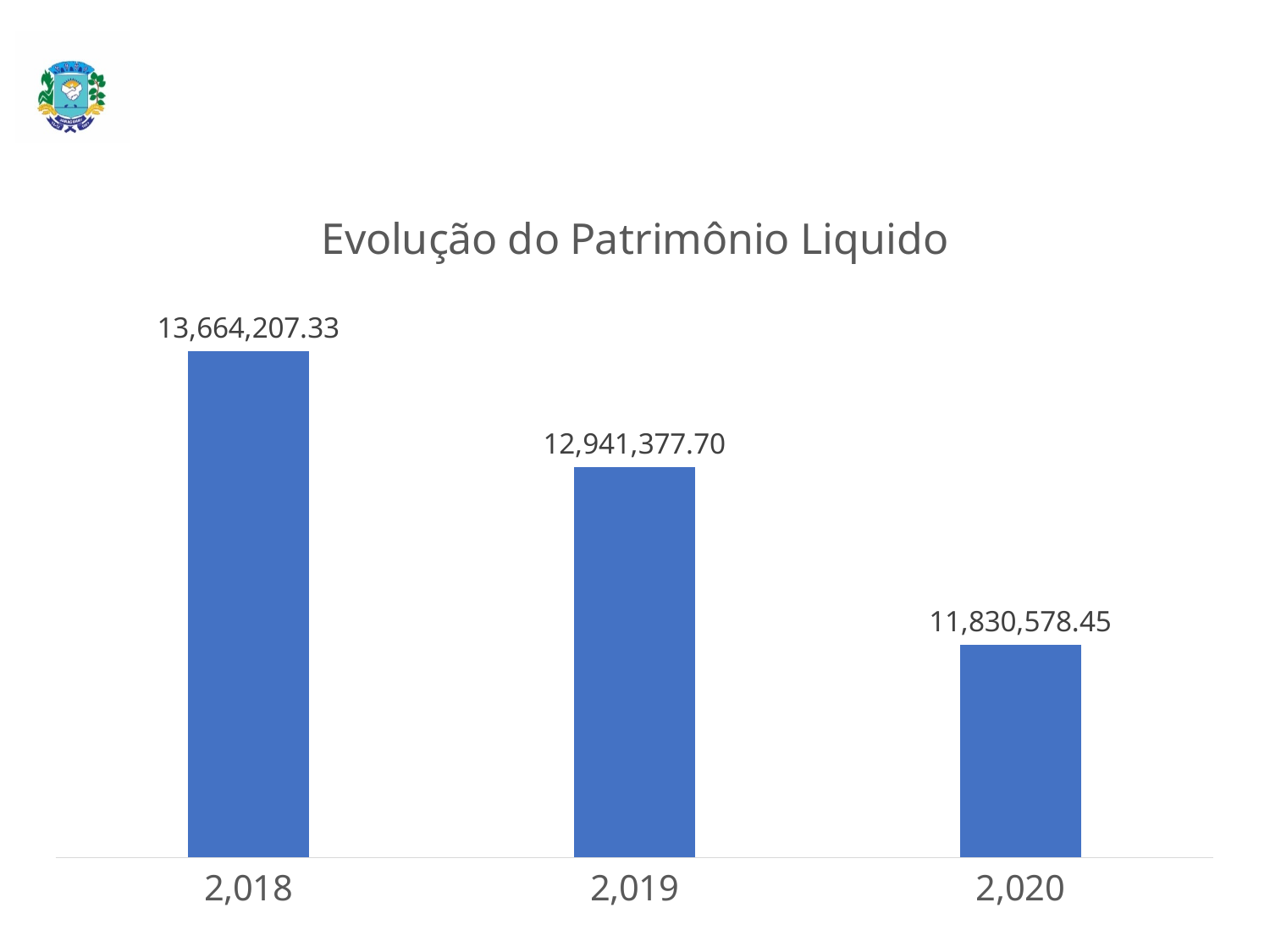
Which year has the highest value? 2,018 What is the difference between the values for 2,018 and 2,019? 722,829.63 Which year has the lowest value? 2,020 What is the value for 2,019? 12,941,377.70 How many years are shown on the chart? 3 What is the value for 2,018? 13,664,207.33 What is the difference between the values for 2,019 and 2,020? 1,110,799.25 Which is larger, the value for 2,019 or the value for 2,020? 2,019 What is the value for 2,020? 11,830,578.45 Do the values rise or fall from 2,018 to 2,020? Fall What kind of chart is this? Bar chart What is the difference between the values for 2,018 and 2,020? 1,833,628.88